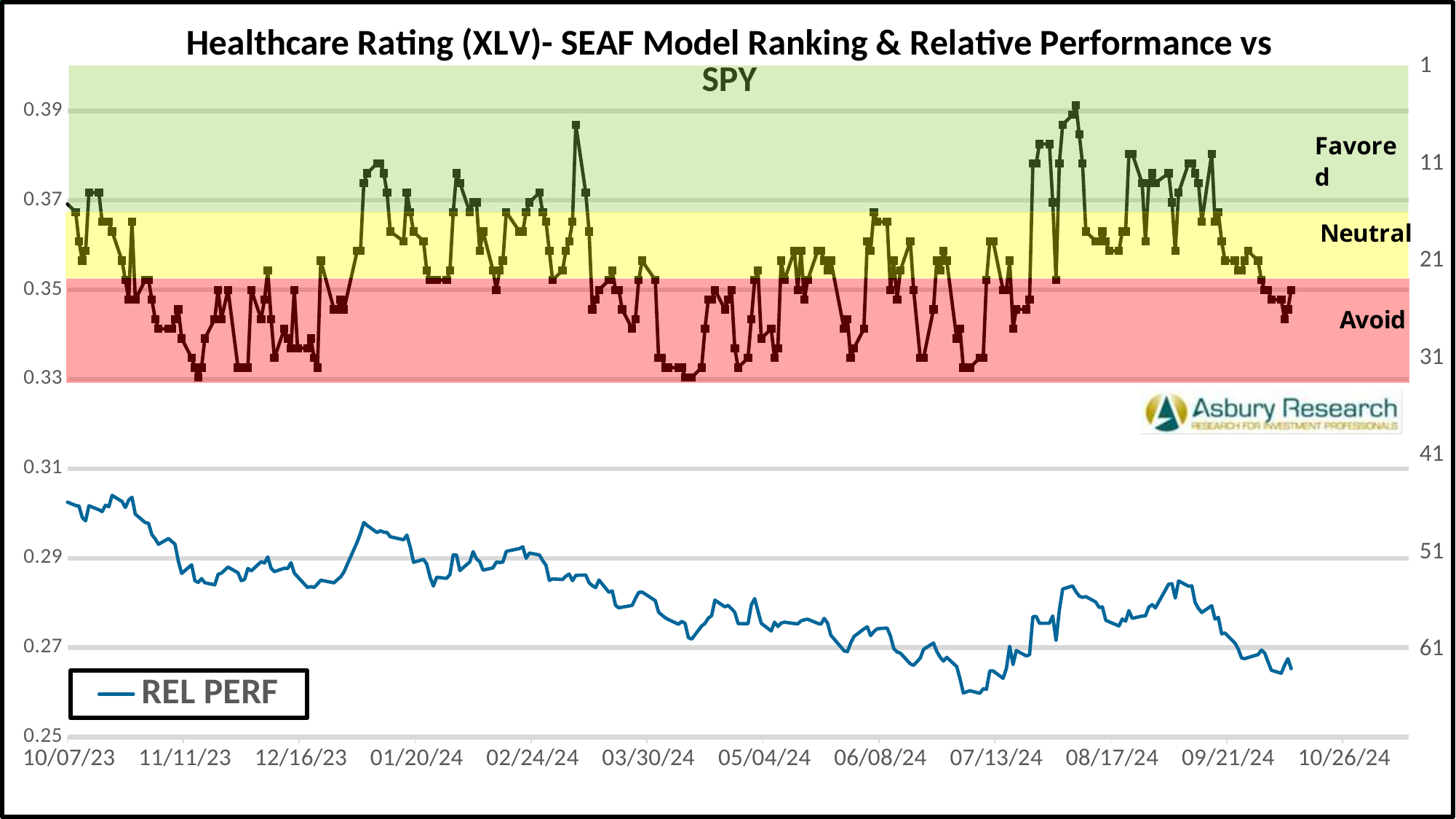
Is the REL PERF value higher at 07/13/24 or at 08/17/24? 08/17/24 How many series does the legend list? 1 Does the REL PERF line overall rise or fall from 10/07/23 to the end of the chart? fall Is the REL PERF value at 03/30/24 greater or less than 0.27? greater Is the REL PERF value at 07/13/24 greater or less than 0.27? less What is the name of the series shown in the legend? REL PERF Is the REL PERF value at 10/07/23 greater or less than 0.29? greater What is the title of the chart? Healthcare Rating (XLV)- SEAF Model Ranking & Relative Performance vs SPY Which of the three shaded zones (Favored, Neutral, Avoid) is the SEAF model ranking line in at the right end of the chart? Avoid What kind of chart is shown on the slide? line chart How many date labels are shown on the x axis? 12 Is the REL PERF value higher at 10/07/23 or at 09/21/24? 10/07/23